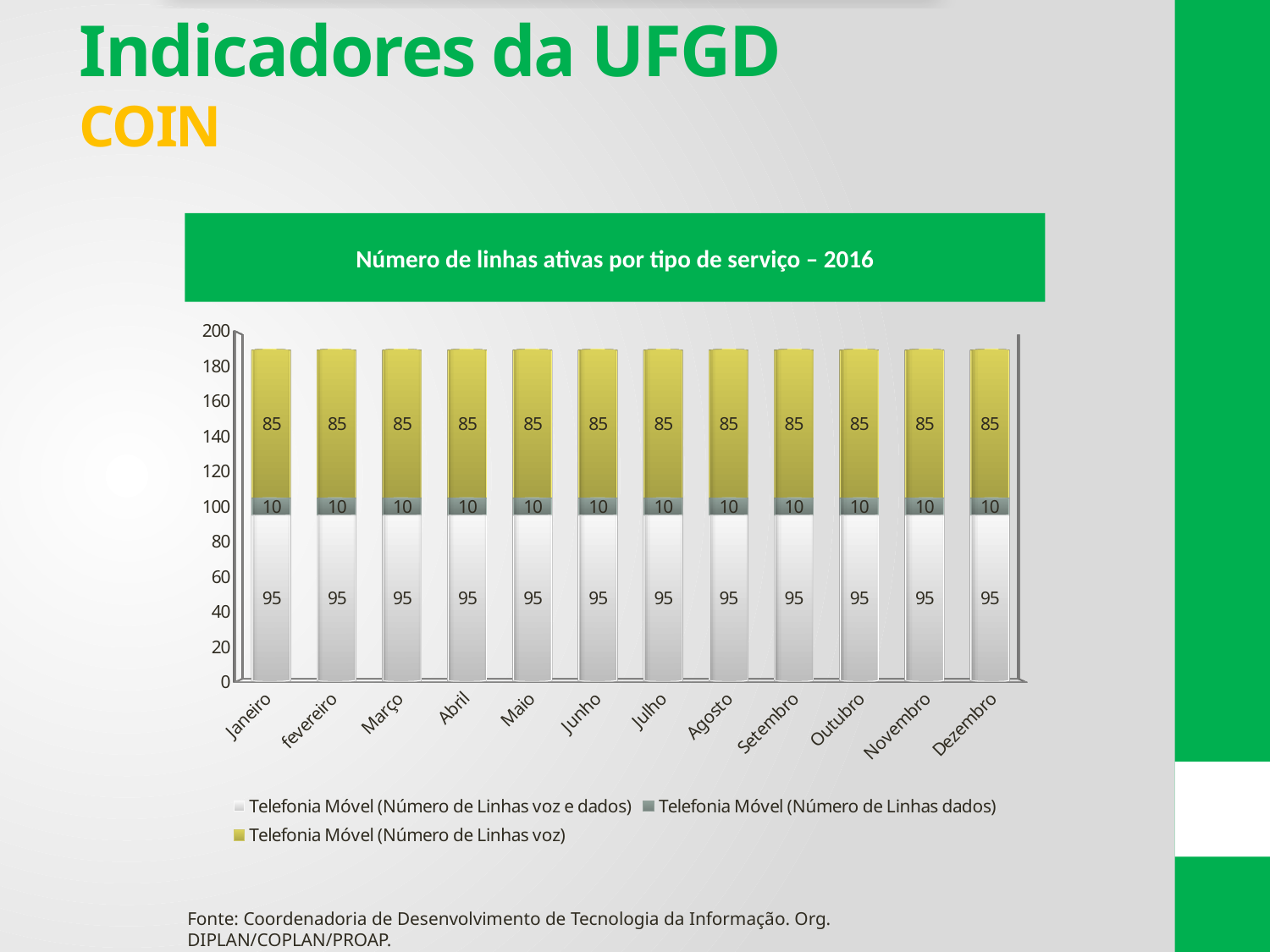
What is the value for Telefonia Móvel (Número de Linhas dados) in Julho? 10 In Agosto, which is larger: Número de Linhas voz e dados or Número de Linhas dados? Número de Linhas voz e dados What is the value for Telefonia Móvel (Número de Linhas voz) in Janeiro? 85 Do the total values rise, fall, or stay the same from Janeiro to Dezembro? Stay the same What is the difference between the Número de Linhas voz e dados value and the Número de Linhas voz value in Maio? 10 What is the title of the chart? Número de linhas ativas por tipo de serviço – 2016 How many months are shown on the x axis? 12 How many series does the legend list? 3 What kind of chart is this? Stacked bar chart What is the total of the stacked bar for Março? 190 Which series is shown in yellow? Telefonia Móvel (Número de Linhas voz) What is the value for Telefonia Móvel (Número de Linhas voz e dados) in Dezembro? 95